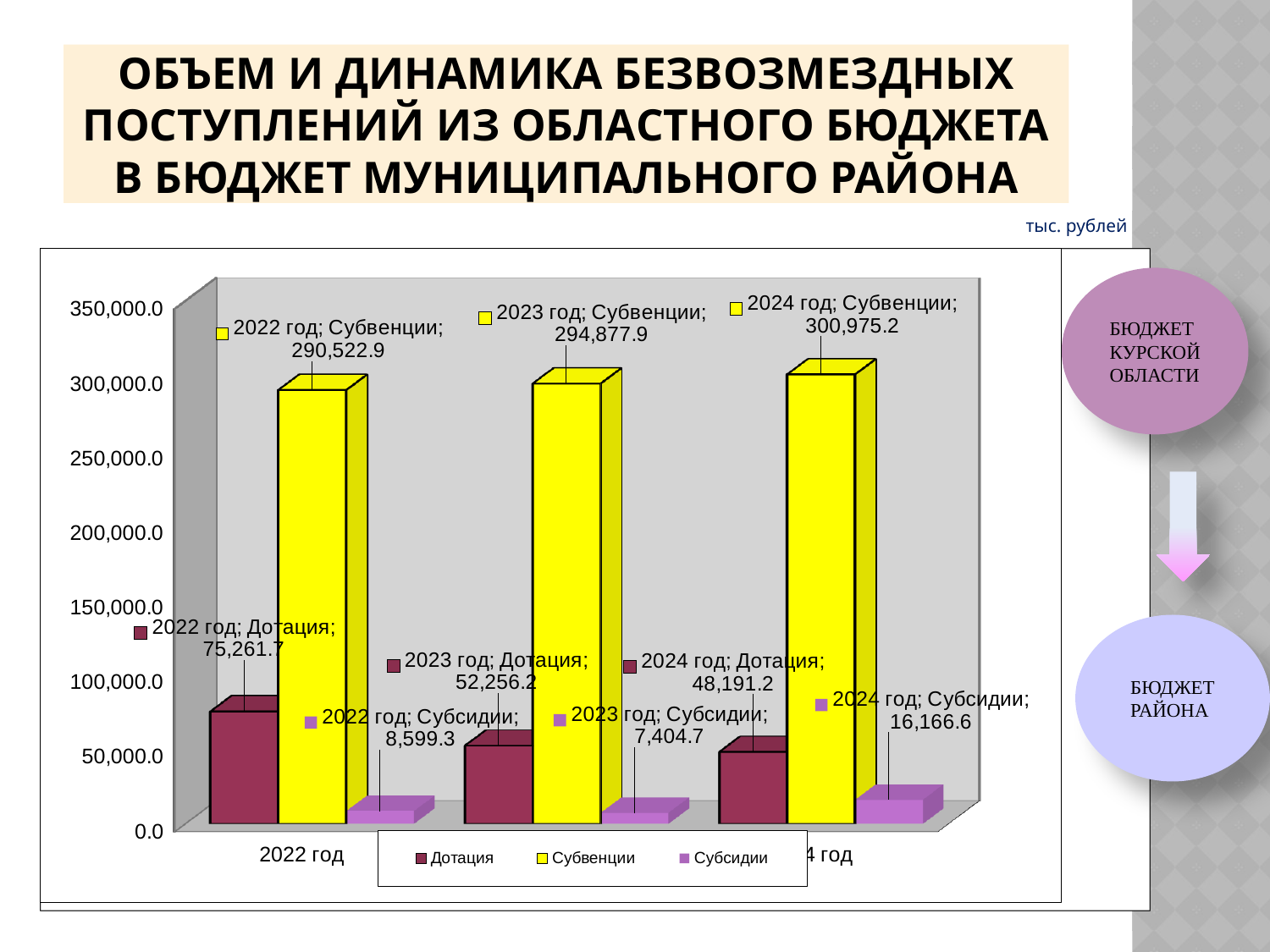
What is the value of Субвенции for 2022 год? 290,522.9 In which year is the value of Субсидии the lowest? 2023 год Do the Дотация values rise or fall from 2022 год to 2024 год? fall What kind of chart is shown on the slide? bar chart What is the difference between the Субвенции values for 2024 год and 2022 год? 10,452.3 Is the value of Дотация for 2022 год greater or less than 100,000.0? less In which year is the value of Субвенции the highest? 2024 год What is the value of Дотация for 2024 год? 48,191.2 What is the difference between the Дотация values for 2022 год and 2024 год? 27,070.5 Which is larger: Дотация for 2023 год or Дотация for 2024 год? Дотация for 2023 год How many series does the legend list? 3 What is the value of Субсидии for 2023 год? 7,404.7